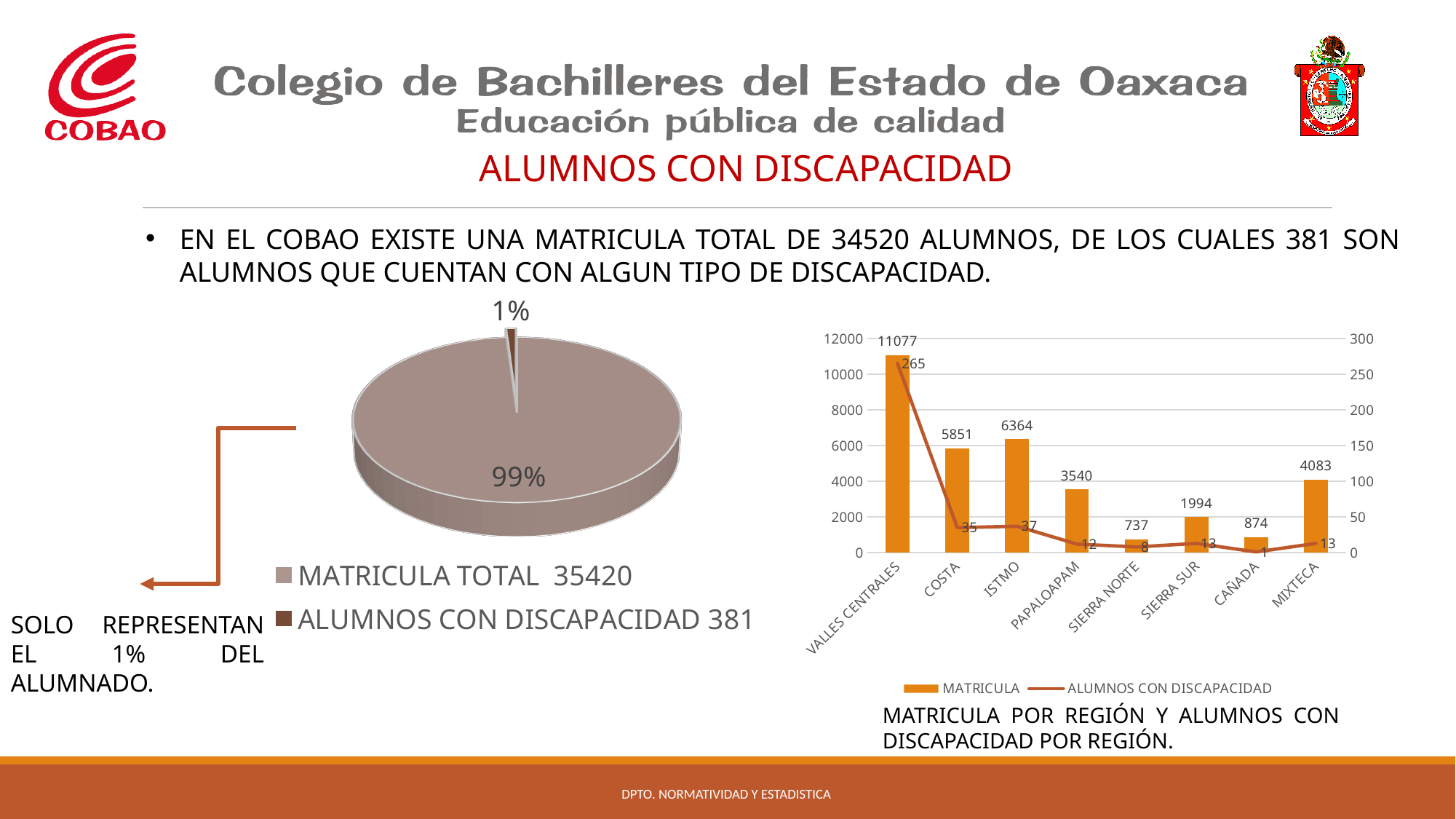
In the chart on the right, which region has the lowest MATRICULA? SIERRA NORTE In the chart on the right, which region has the highest ALUMNOS CON DISCAPACIDAD value? VALLES CENTRALES In the pie chart on the left, how many slices does the legend list? 2 In the pie chart on the left, what share of the pie is labelled for ALUMNOS CON DISCAPACIDAD? 1% In the chart on the right, how many series does the legend list? 2 In the chart on the right, what is the ALUMNOS CON DISCAPACIDAD value for COSTA? 35 In the chart on the right, what is the difference in MATRICULA between ISTMO and COSTA? 513 In the chart on the right, which has a larger MATRICULA, PAPALOAPAM or SIERRA SUR? PAPALOAPAM In the pie chart on the left, what share of the pie is labelled for MATRICULA TOTAL? 99% In the chart on the right, what is the MATRICULA value for MIXTECA? 4083 In the chart on the right, how many regions are shown on the x axis? 8 In the chart on the right, what is the MATRICULA value for VALLES CENTRALES? 11077